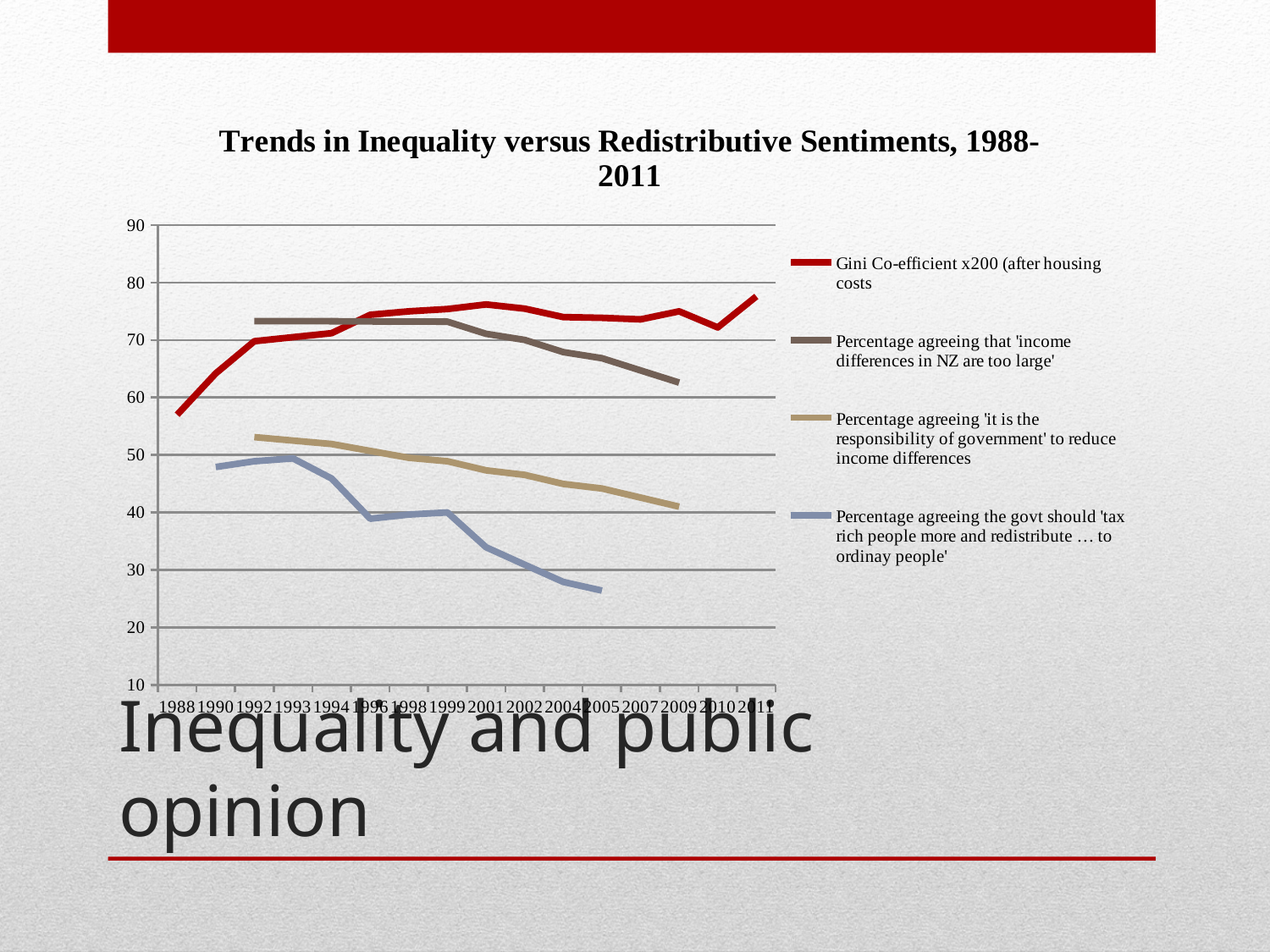
How many series does the legend list? 4 Is the value for 'Percentage agreeing that income differences in NZ are too large' in 2009 greater or less than 60? greater Is the Gini Co-efficient x200 value for 2011 greater or less than 70? greater What kind of chart is shown on the slide? line chart Does the 'Percentage agreeing the govt should tax rich people more and redistribute' series rise or fall from 1990 to 2005? fall Which series is drawn in red? Gini Co-efficient x200 (after housing costs Is the Gini Co-efficient x200 value for 1988 greater or less than 60? less Which series has the lowest values on the chart? Percentage agreeing the govt should 'tax rich people more and redistribute … to ordinay people' How many years are labelled on the x axis? 16 In 2009, which is larger: the Gini Co-efficient x200 or the percentage agreeing that income differences in NZ are too large? Gini Co-efficient x200 What is the title of the chart? Trends in Inequality versus Redistributive Sentiments, 1988-2011